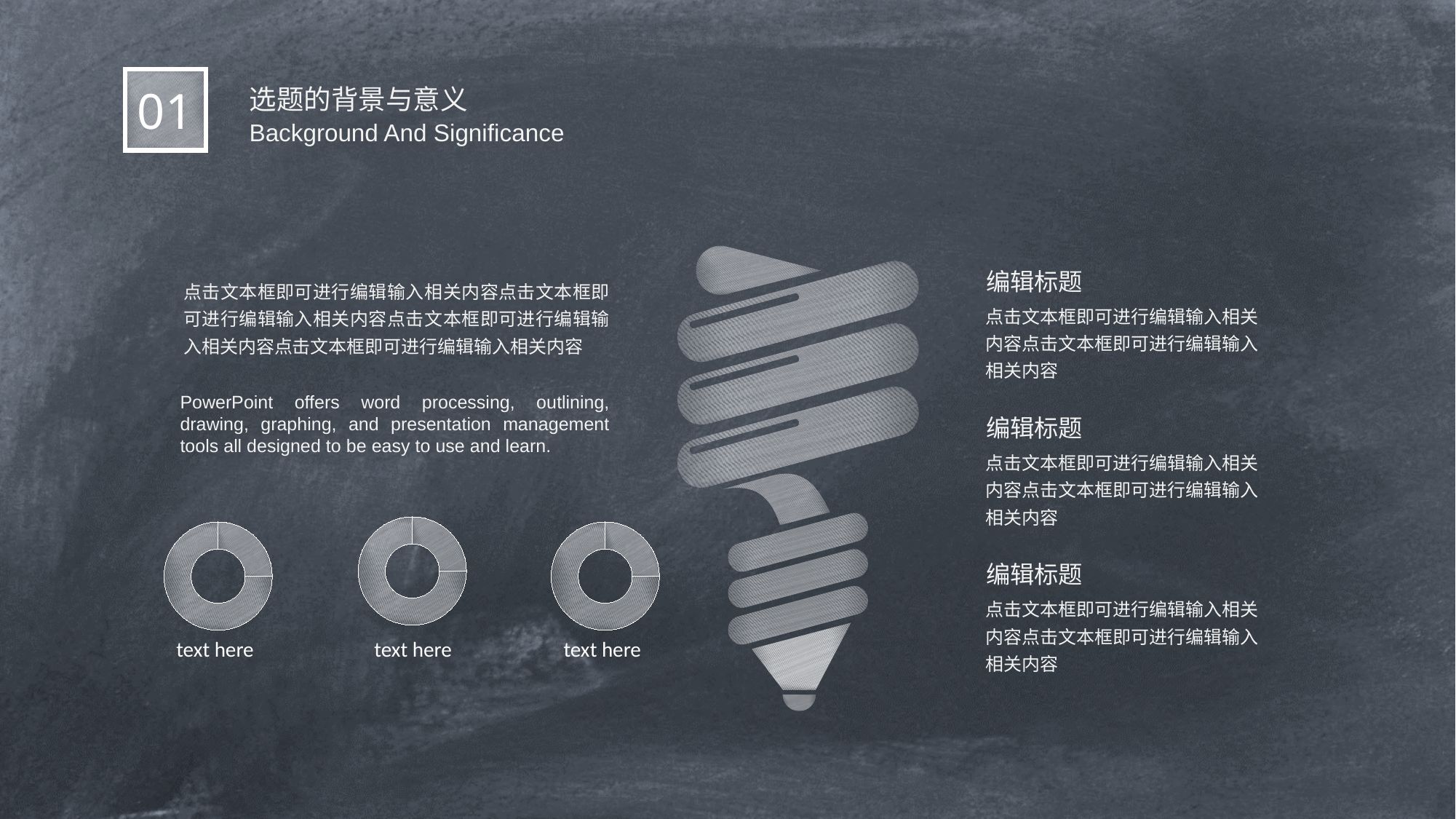
How many slices does the leftmost donut chart appear to be divided into? 2 How many donut charts are shown on the slide? 3 In the leftmost donut chart, is the top-right slice larger or smaller than the other slice? smaller Do the donut charts display any numeric data labels? No What kind of chart are the three small charts at the bottom left of the slide? Donut (pie) charts What label appears beneath each of the three donut charts? text here